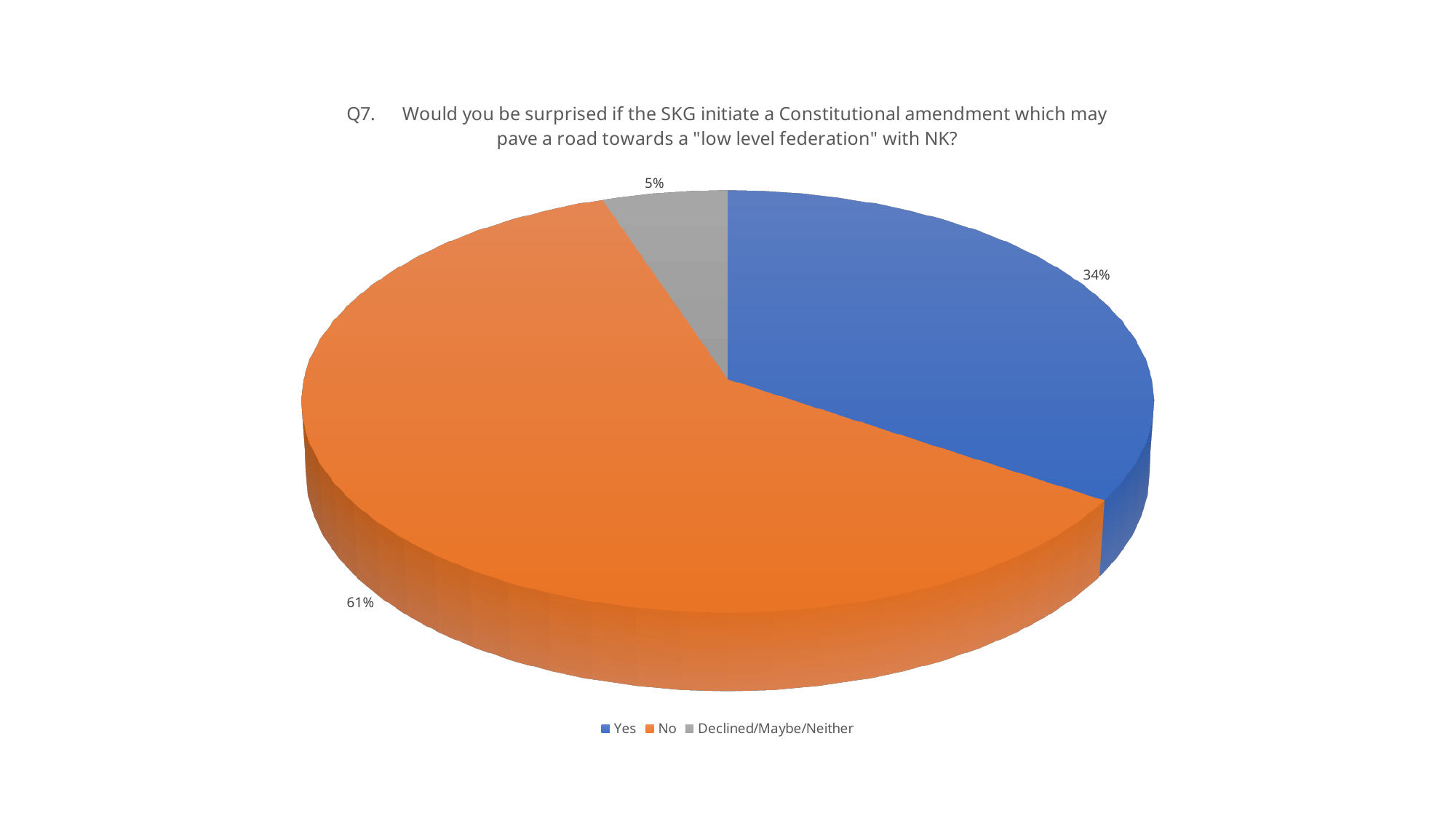
Which response has the largest share of the pie? No What is the difference in percentage points between the "No" and "Yes" shares? 27 Which question number does the chart title refer to? Q7 Which is larger, the share for "Yes" or the share for "Declined/Maybe/Neither"? Yes How many slices does the pie chart have? 3 Which response has the smallest share of the pie? Declined/Maybe/Neither What share of responses is "Yes"? 34% What share of responses is "No"? 61% How many entries does the legend list? 3 What kind of chart is shown on the slide? pie chart What colour is the "No" slice? orange What share of responses is "Declined/Maybe/Neither"? 5%